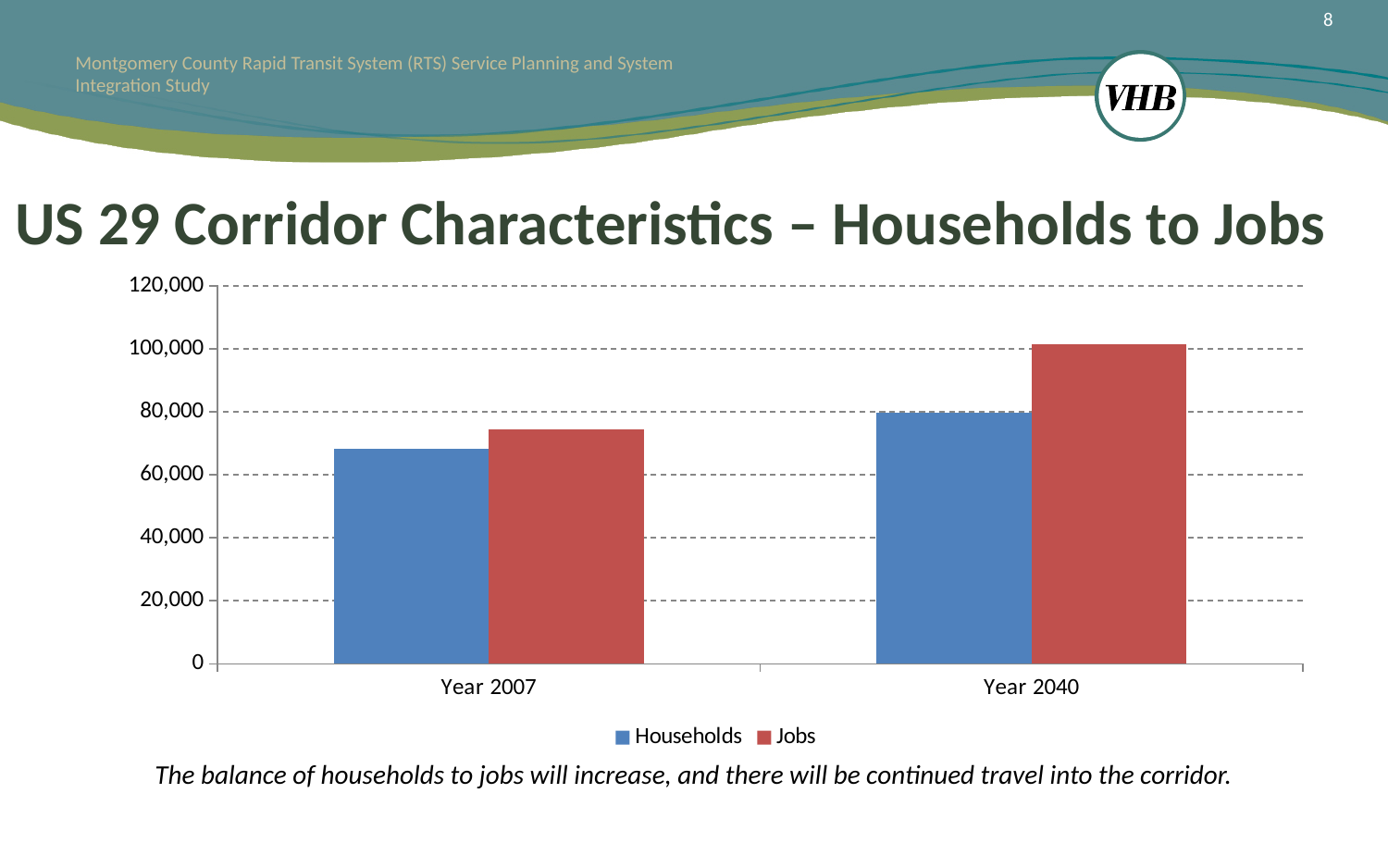
What kind of chart is shown on the slide? Bar chart How many year categories are shown on the x axis? 2 Is the value for Jobs in Year 2007 greater or less than 60,000? greater Which series and year has the shortest bar? Households in Year 2007 What colour are the Jobs bars? Red In Year 2007, which is larger, Households or Jobs? Jobs Is the value for Households in Year 2007 greater or less than 80,000? less In Year 2040, which is larger, Households or Jobs? Jobs How many series does the legend list? 2 Do the Households values rise or fall from Year 2007 to Year 2040? Rise Is the value for Jobs in Year 2040 greater or less than 80,000? greater Which series and year has the tallest bar? Jobs in Year 2040